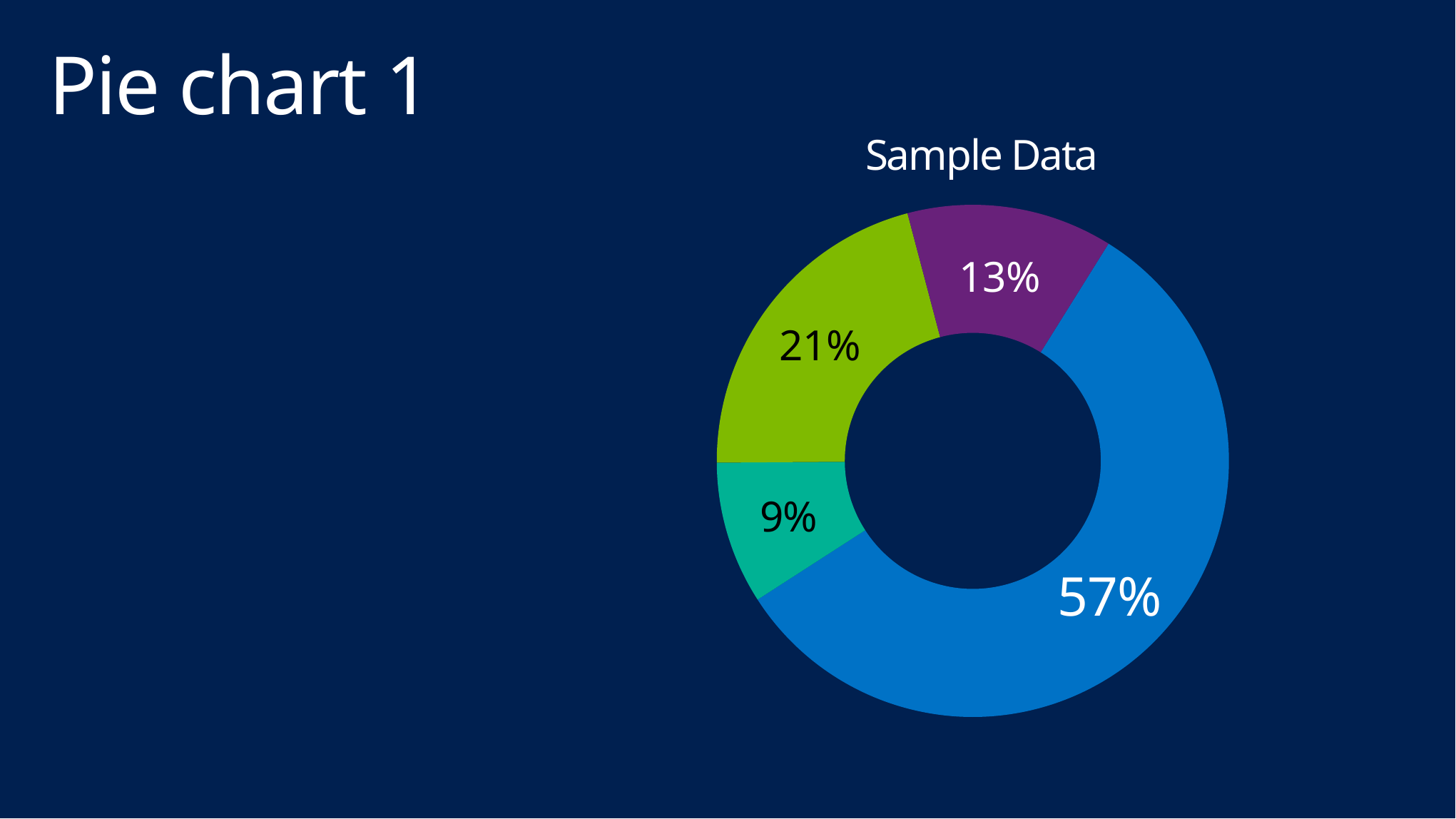
What kind of chart is shown on the slide? Pie chart (doughnut) What is the difference in percentage points between the blue slice and the green slice? 36 percentage points Which slice has the largest share? The blue slice (57%) What percentage is shown on the purple slice? 13% Which slice has the smallest share? The teal slice (9%) What percentage is shown on the teal slice? 9% What percentage is shown on the green slice? 21% What is the difference in percentage points between the purple slice and the teal slice? 4 percentage points What is the title of the chart? Sample Data Which is larger, the green slice or the purple slice? The green slice How many slices does the chart have? 4 What percentage is shown on the blue slice? 57%